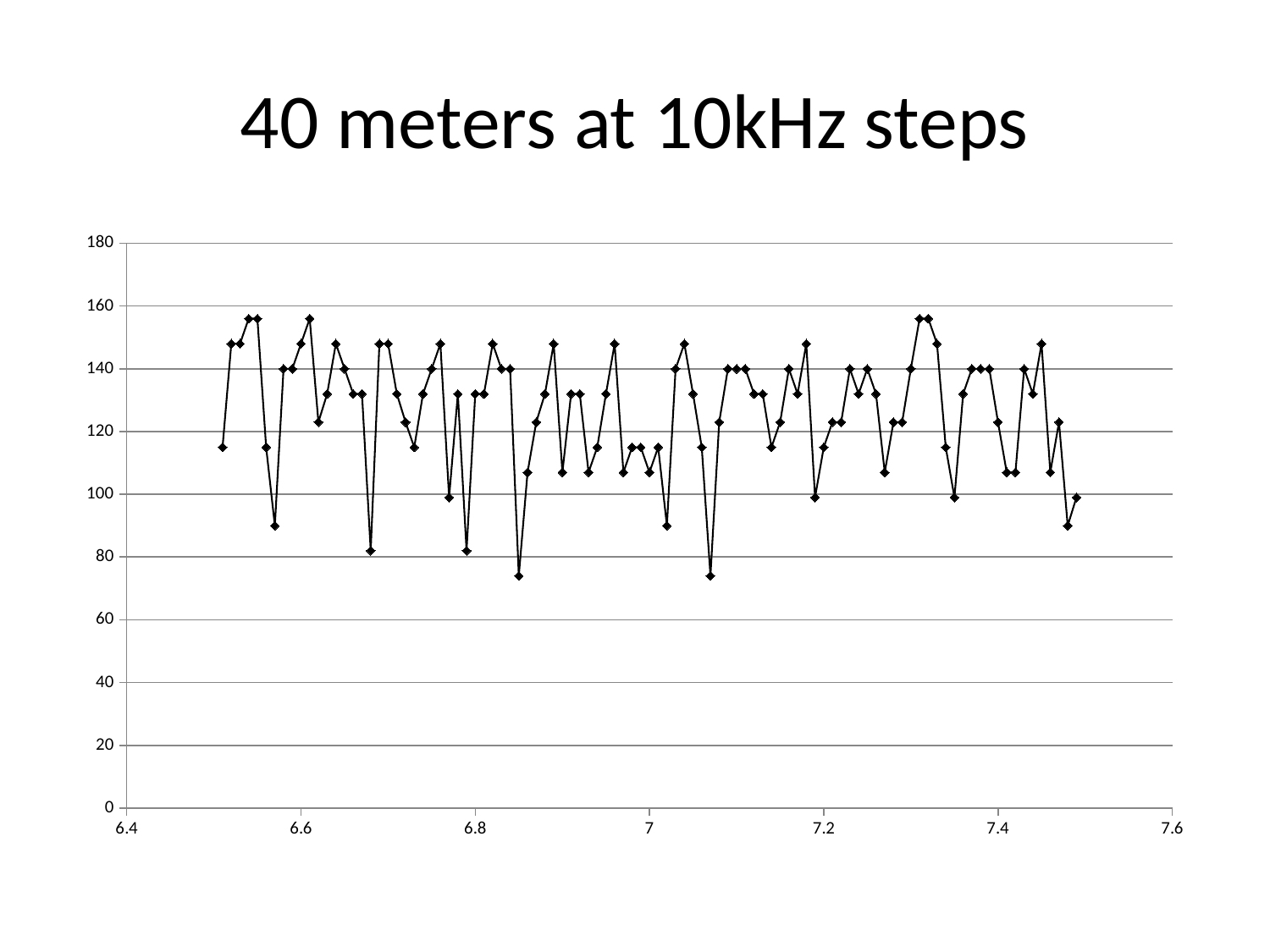
Is the last plotted point (at the far right) greater or less than 120? less Is the lowest plotted value greater or less than 60? greater Is the first plotted point greater or less than the last plotted point? greater Is the highest plotted value greater or less than 140? greater What is the highest value shown on the vertical axis? 180 What kind of chart is shown on the slide? line chart What is the title of the chart? 40 meters at 10kHz steps